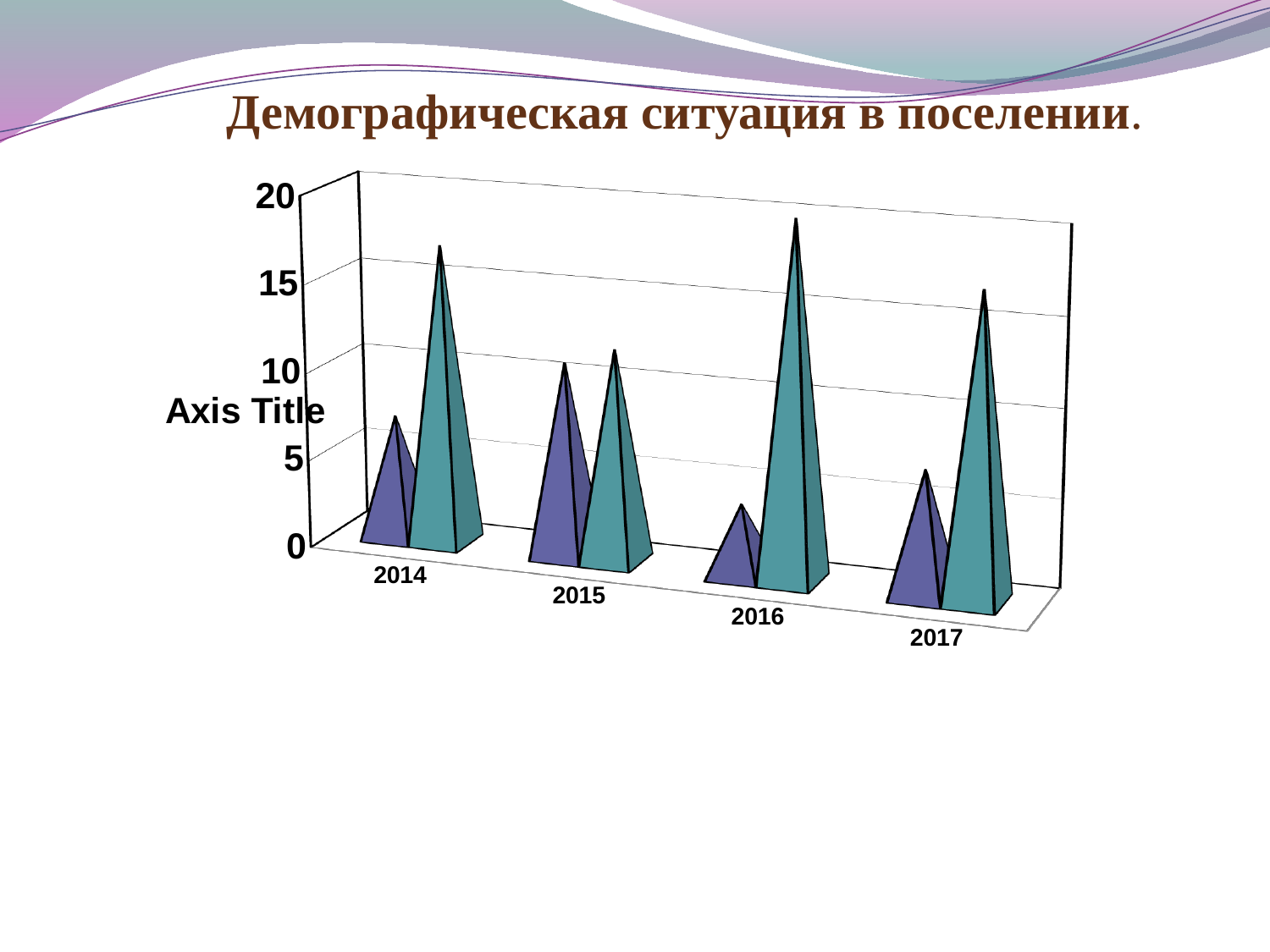
Is the value of the teal series for 2014 greater or less than 15? greater In which year is the teal series highest? 2016 In which year is the purple series highest? 2015 How many years are shown on the x axis of the chart? 4 In which year is the teal series lowest? 2015 In which year is the purple series lowest? 2016 What is the title of the chart on the slide? Демографическая ситуация в поселении Is the value of the purple series for 2016 greater or less than 5? less What kind of chart is shown on the slide? bar chart Does the purple series rise or fall from 2015 to 2016? fall In 2016, which series has the larger value, the purple one or the teal one? teal What text is shown as the vertical axis title? Axis Title